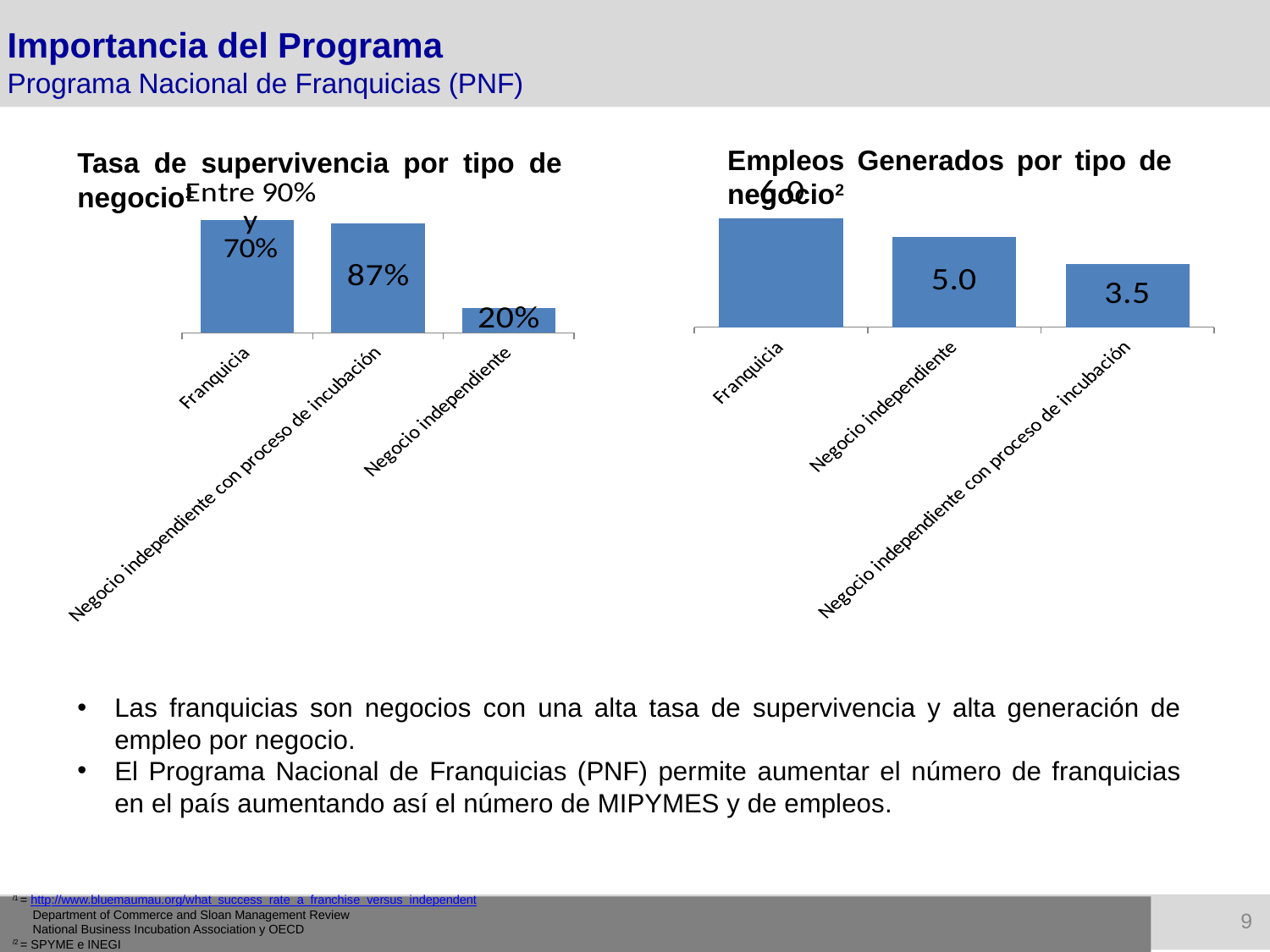
In the chart 'Empleos Generados por tipo de negocio', which type of business generates the fewest jobs? Negocio independiente con proceso de incubación In the chart 'Empleos Generados por tipo de negocio', how many jobs are generated by 'Negocio independiente con proceso de incubación'? 3.5 In the chart 'Empleos Generados por tipo de negocio', how many jobs are generated by 'Negocio independiente'? 5.0 In the chart 'Empleos Generados por tipo de negocio', what is the difference in jobs generated between 'Negocio independiente' and 'Negocio independiente con proceso de incubación'? 1.5 In the chart 'Tasa de supervivencia por tipo de negocio', which type of business has the lowest survival rate? Negocio independiente In the chart 'Tasa de supervivencia por tipo de negocio', what is the survival rate for 'Negocio independiente'? 20% In the chart 'Tasa de supervivencia por tipo de negocio', what label is shown on the 'Franquicia' bar? Entre 90% y 70% What type of chart is 'Empleos Generados por tipo de negocio'? Bar chart In the chart 'Tasa de supervivencia por tipo de negocio', how many business types are shown? 3 In the chart 'Tasa de supervivencia por tipo de negocio', what is the difference between the survival rates of 'Negocio independiente con proceso de incubación' and 'Negocio independiente'? 67% In the chart 'Tasa de supervivencia por tipo de negocio', what is the survival rate for 'Negocio independiente con proceso de incubación'? 87% In the chart 'Empleos Generados por tipo de negocio', which type of business generates the most jobs? Franquicia